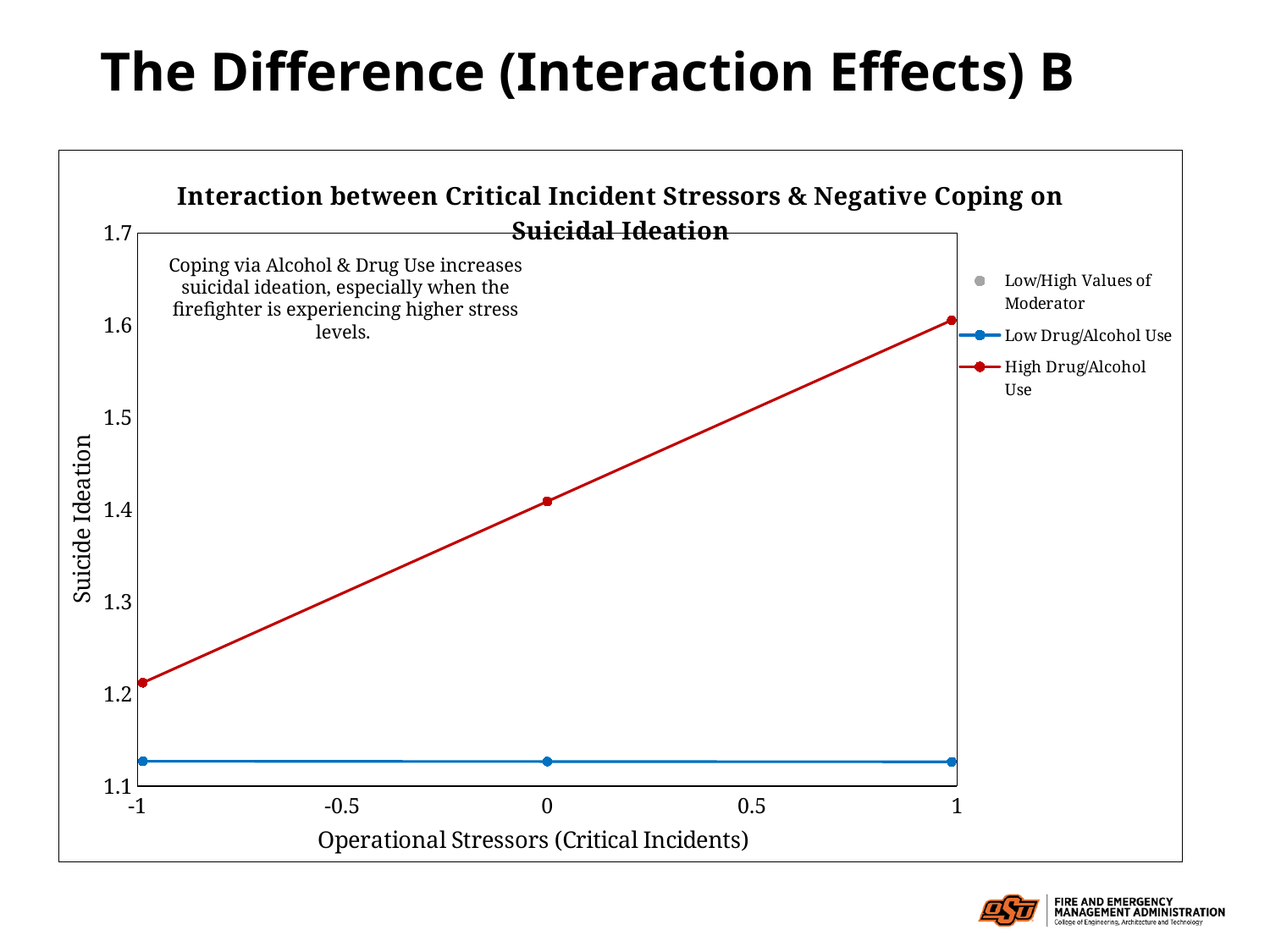
Does the High Drug/Alcohol Use line rise or fall as Operational Stressors increase from -1 to 1? Rises What is the label on the x axis of the chart? Operational Stressors (Critical Incidents) At which Operational Stressors value does the High Drug/Alcohol Use series have its lowest Suicide Ideation? -1 What kind of chart is shown on the slide? Line chart Does the Low Drug/Alcohol Use line rise, fall, or stay flat as Operational Stressors increase from -1 to 1? Stays flat How many data points are plotted for the High Drug/Alcohol Use series? 3 At Operational Stressors = 1, which series has the higher Suicide Ideation value: Low Drug/Alcohol Use or High Drug/Alcohol Use? High Drug/Alcohol Use Is the Suicide Ideation value for Low Drug/Alcohol Use at Operational Stressors = 0 greater or less than 1.2? less Is the Suicide Ideation value for High Drug/Alcohol Use at Operational Stressors = 1 greater or less than 1.5? greater How many entries does the chart legend list? 3 At which Operational Stressors value does the High Drug/Alcohol Use series reach its highest Suicide Ideation? 1 Is the Suicide Ideation value for High Drug/Alcohol Use at Operational Stressors = -1 greater or less than 1.3? less